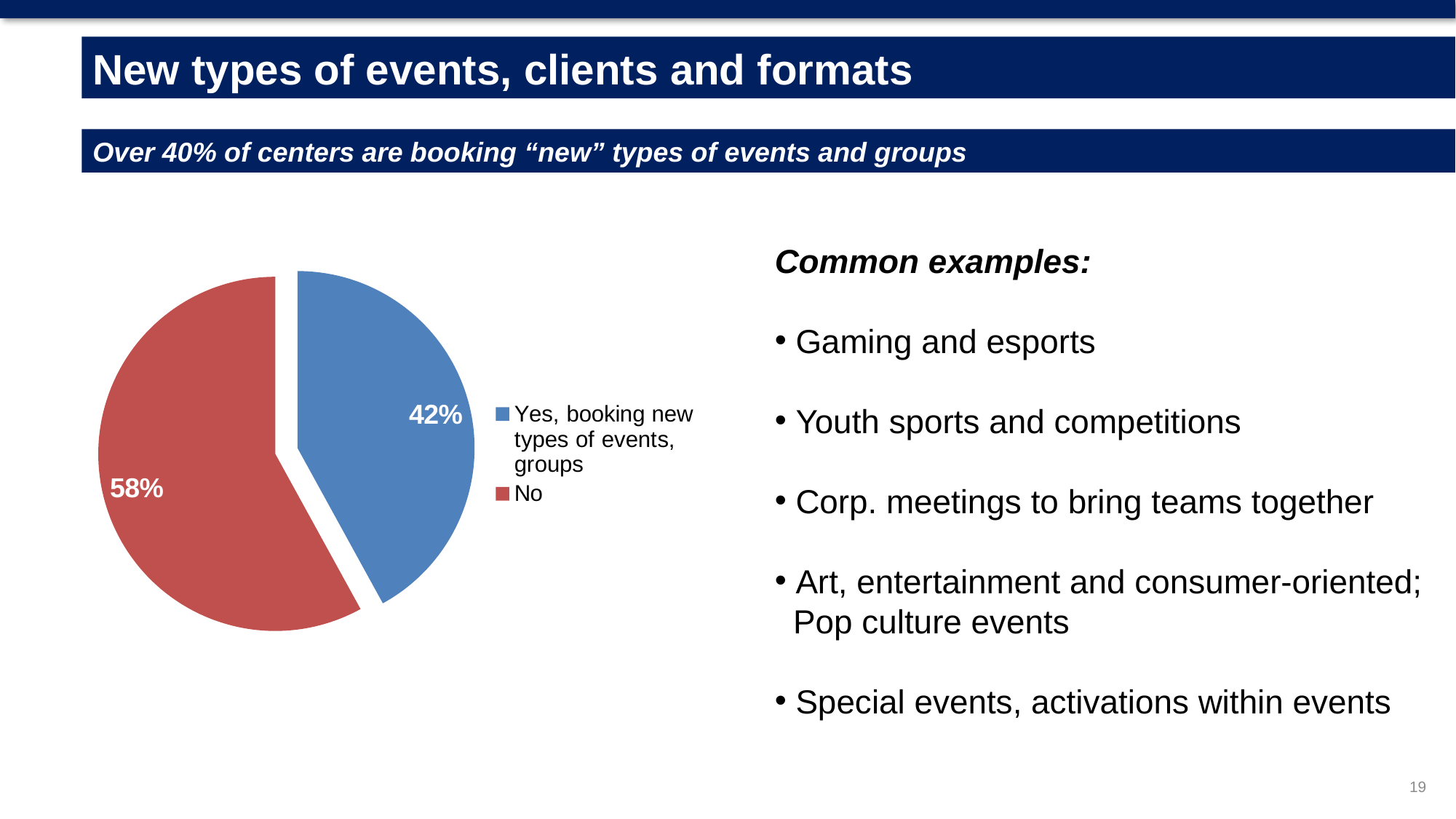
What colour is the "No" slice of the pie? red How many slices does the pie chart have? 2 What share of the pie is labelled "No"? 58% What is the difference in percentage points between the "No" slice and the "Yes, booking new types of events, groups" slice? 16 What kind of chart is shown on the slide? pie chart Which slice of the pie is the smallest? Yes, booking new types of events, groups Which is larger: the "No" slice or the "Yes, booking new types of events, groups" slice? No What share of the pie is labelled "Yes, booking new types of events, groups"? 42% Which slice of the pie is the largest? No What colour is the "Yes, booking new types of events, groups" slice of the pie? blue How many entries does the legend list? 2